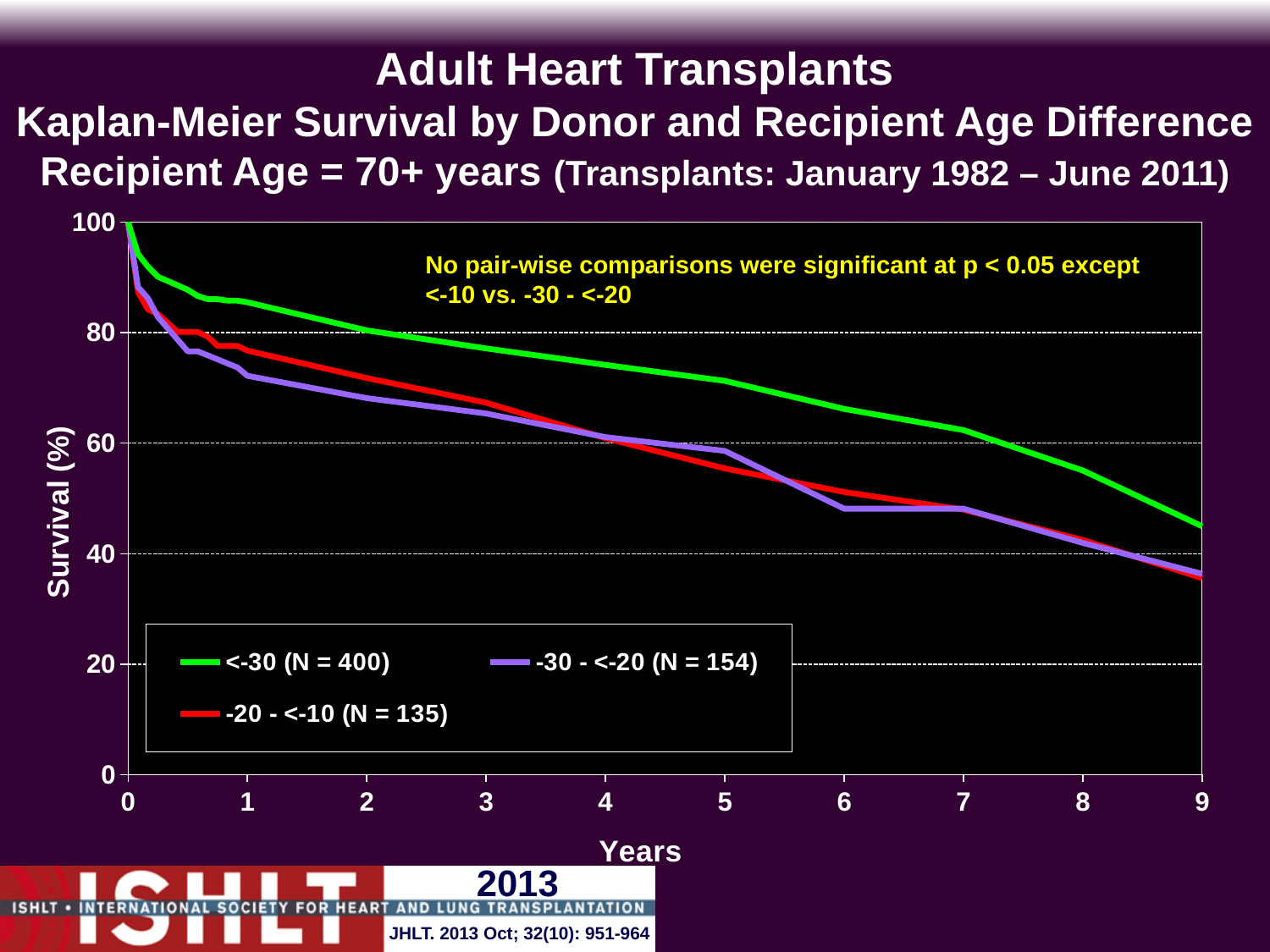
At year 9, which group has higher survival: <-30 or -20 - <-10? <-30 Is the survival value for the -30 - <-20 group at year 6 greater or less than 40? greater Is the survival value for the <-30 group at year 8 greater or less than 60? less Is the survival value for the <-30 group at year 5 greater or less than 60? greater What colour is the line for the -20 - <-10 group? Red Does survival for the <-30 group rise or fall as years increase? Fall Which group has the highest survival at year 5? <-30 What kind of chart is shown on the slide? Line chart How many series does the legend list? 3 What is the N shown in the legend for the <-30 group? N = 400